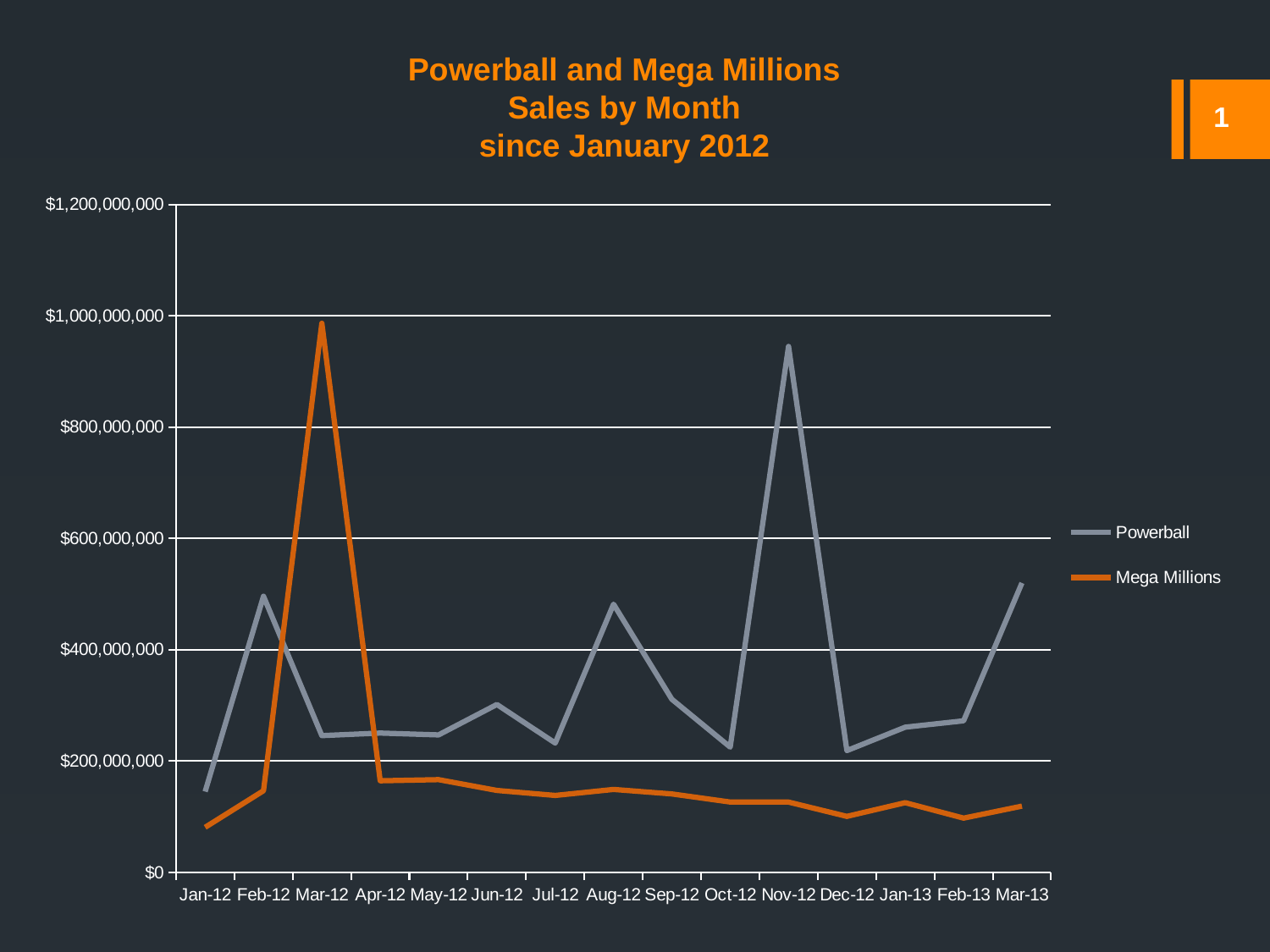
Is the Powerball value for Jan-12 greater or less than $200,000,000? less What kind of chart is shown on the slide? line chart Which series has the larger value in Nov-12, Powerball or Mega Millions? Powerball In which month does the Mega Millions series reach its highest value? Mar-12 Is the Mega Millions value for Mar-12 greater or less than $800,000,000? greater What is the title of the chart? Powerball and Mega Millions Sales by Month since January 2012 Is the Powerball value for Feb-12 greater or less than $400,000,000? greater In which month is the Powerball series at its lowest value? Jan-12 How many months are plotted along the x axis? 15 In which month does the Powerball series reach its highest value? Nov-12 Which series has the larger value in Mar-12, Powerball or Mega Millions? Mega Millions How many series does the legend list? 2